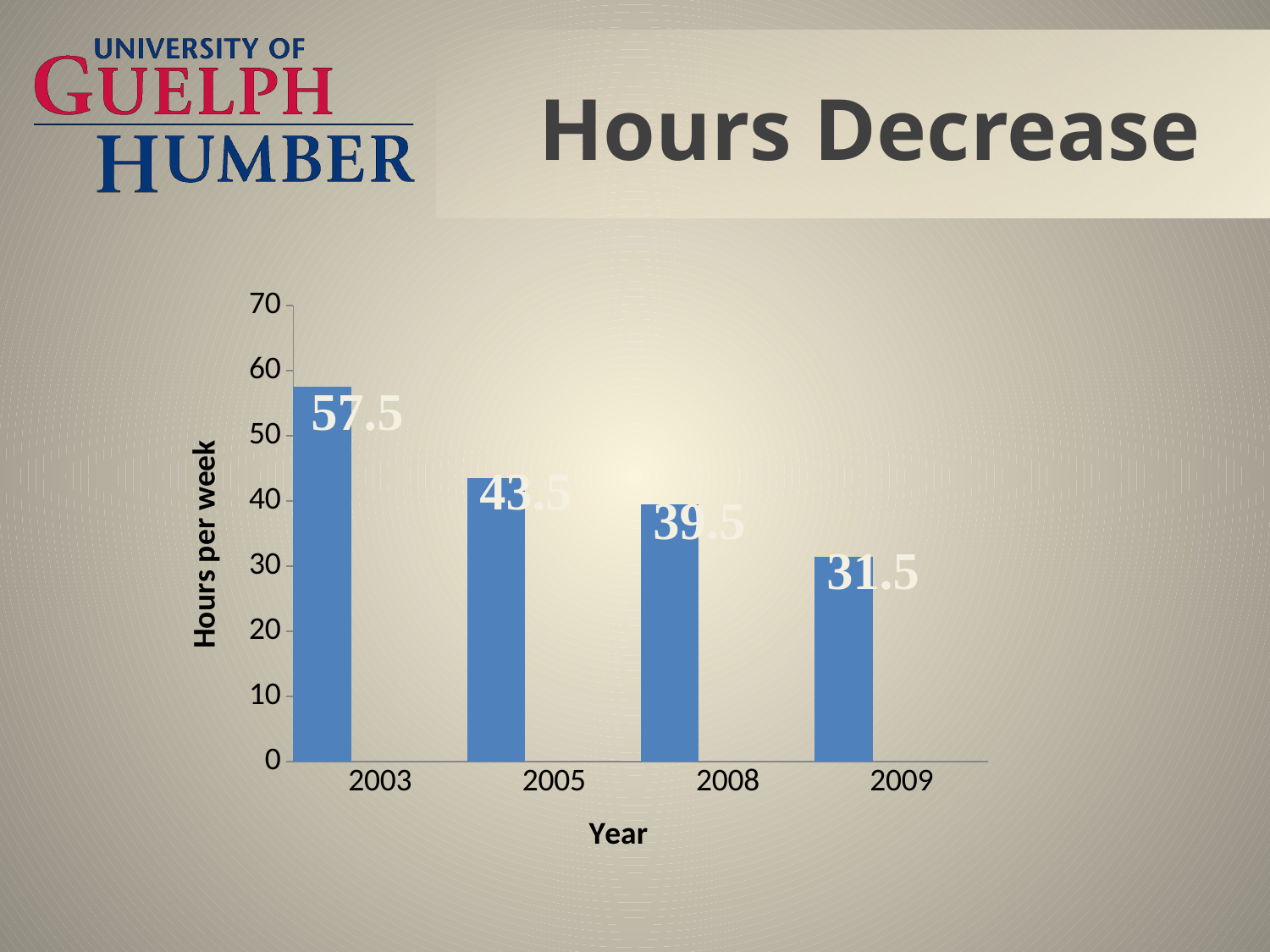
What is the value for 2009? 31.5 What is the value for 2003? 57.5 What is the label of the y axis? Hours per week Which is larger, the value for 2005 or the value for 2008? 2005 Do the values rise or fall from 2003 to 2009? Fall What is the value for 2008? 39.5 Which year has the highest hours per week? 2003 What is the value for 2005? 43.5 Which year has the lowest hours per week? 2009 What is the difference between the values for 2003 and 2009? 26 How many years are shown on the x axis? 4 What kind of chart is shown on the slide? Bar chart